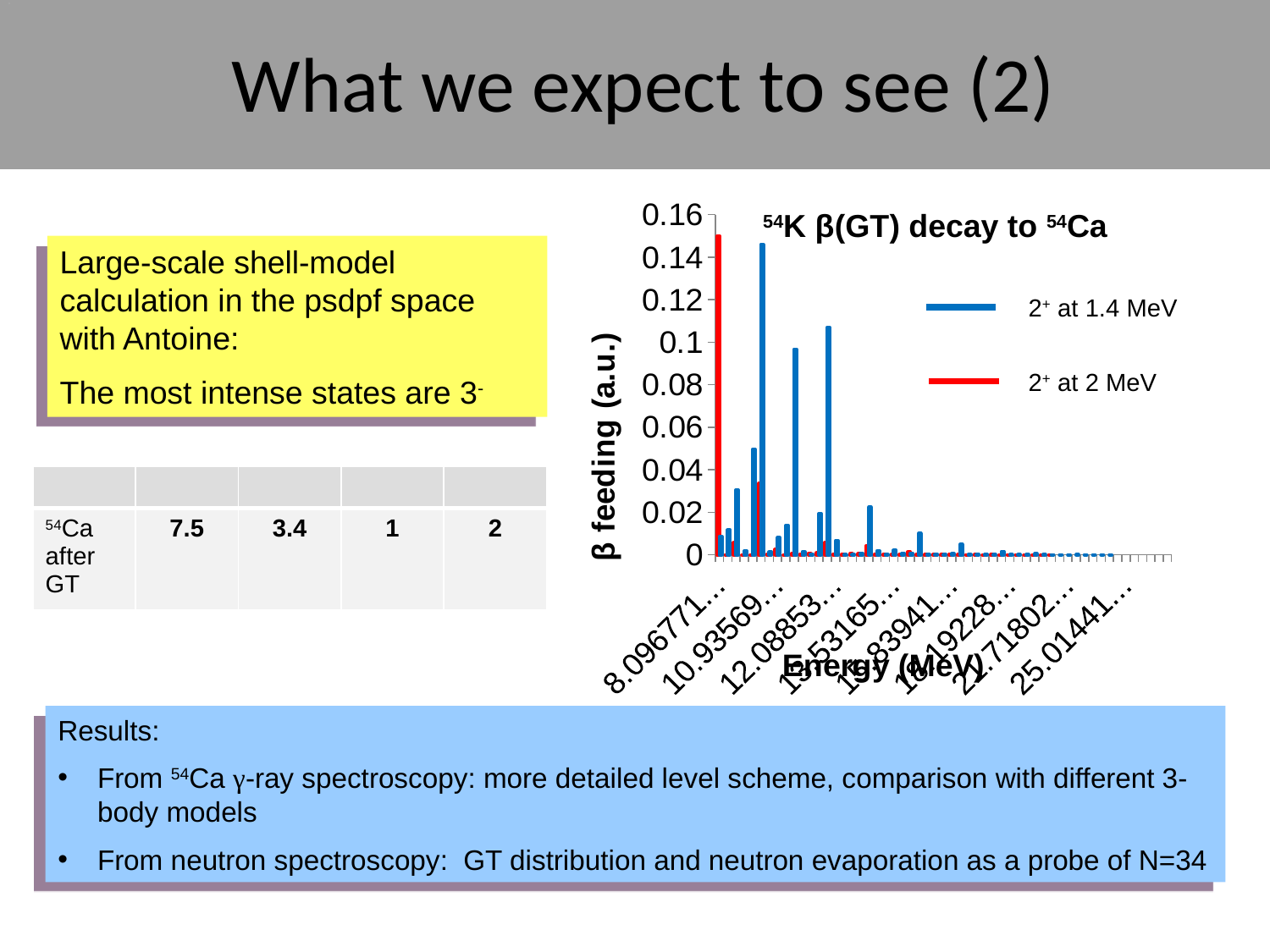
What is the title of the chart? 54K β(GT) decay to 54Ca Is the tallest red bar (2+ at 2 MeV) greater or less than 0.1? greater What is the label of the y axis of the chart? β feeding (a.u.) What kind of chart is shown on the slide? bar chart Is the tallest blue bar (2+ at 1.4 MeV) greater or less than 0.12? greater Do the β feeding values generally rise or fall as energy increases along the x axis? fall What quantity is plotted on the x axis of the chart? Energy (MeV) How many series does the chart legend list? 2 What is the highest tick value shown on the y axis of the chart? 0.16 Which series is drawn in red in the chart? 2+ at 2 MeV